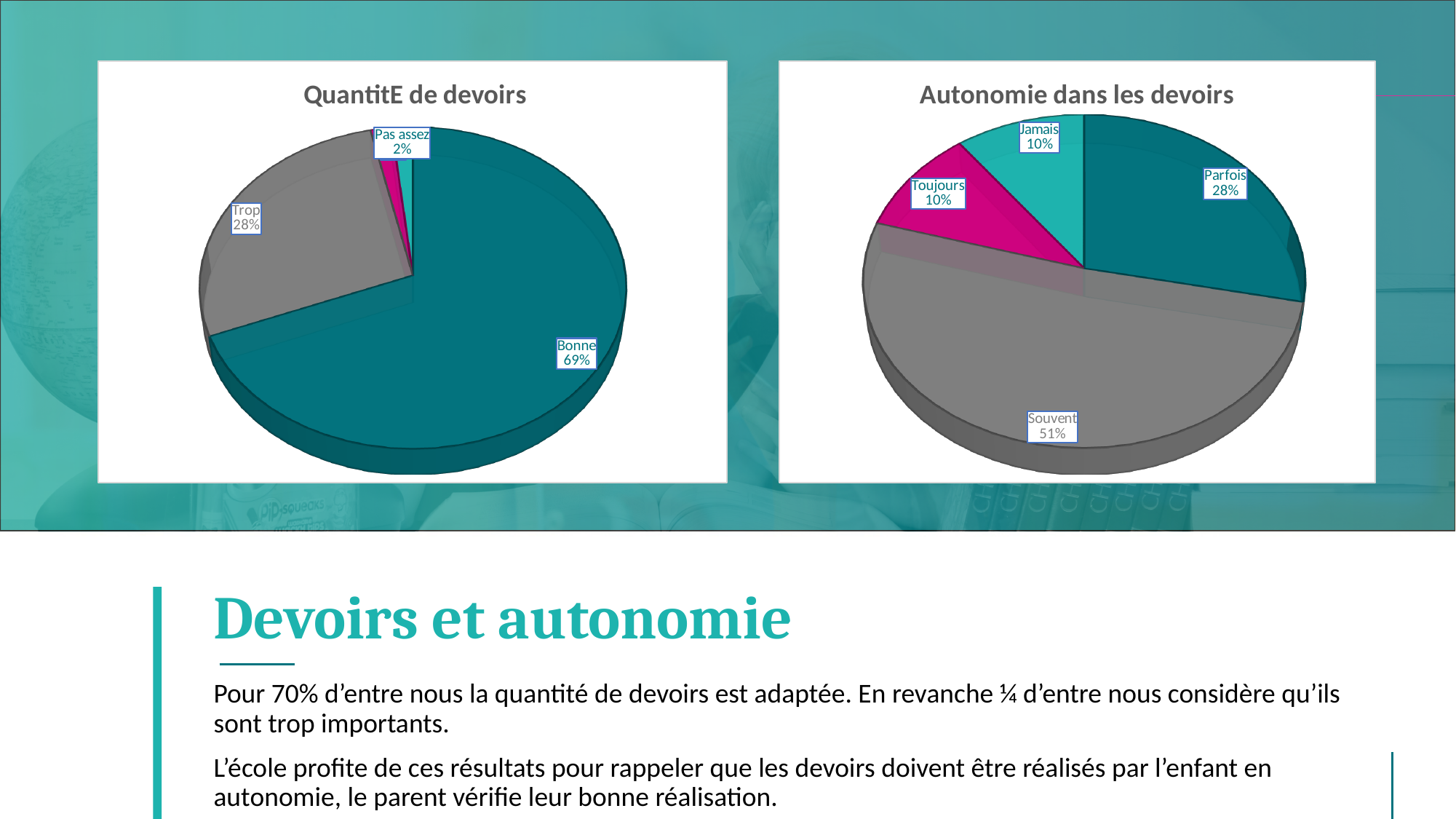
In the 'QuantitE de devoirs' chart, what is the difference between the 'Bonne' and 'Trop' shares? 41% What type of chart is the 'Autonomie dans les devoirs' chart? Pie chart In the 'QuantitE de devoirs' chart, how many slices does the pie have? 4 In the 'Autonomie dans les devoirs' chart, which category has the largest slice? Souvent In the 'Autonomie dans les devoirs' chart, which is larger, 'Parfois' or 'Toujours'? Parfois In the 'Autonomie dans les devoirs' chart, what share does 'Souvent' have? 51% In the 'Autonomie dans les devoirs' chart, what share does 'Parfois' have? 28% In the 'Autonomie dans les devoirs' chart, how many categories are shown? 4 In the 'QuantitE de devoirs' chart, what share does 'Bonne' have? 69% What is the title of the chart on the left of the slide? QuantitE de devoirs In the 'QuantitE de devoirs' chart, what share does 'Trop' have? 28%